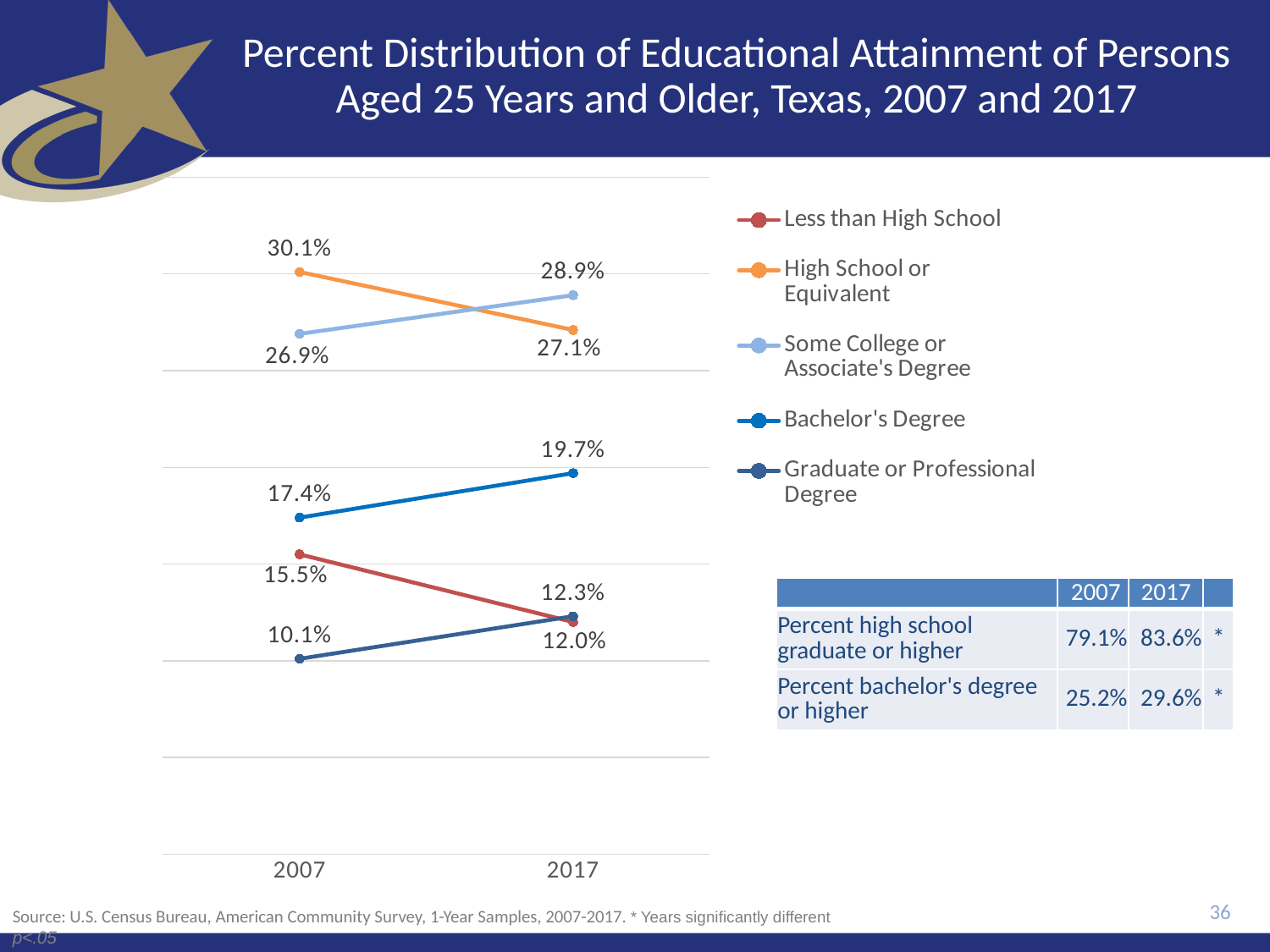
What is the value for High School or Equivalent in 2007? 30.1% Does the value for High School or Equivalent rise or fall from 2007 to 2017? fall Which series has the highest value in 2007? High School or Equivalent What is the value for Less than High School in 2007? 15.5% Which is larger in 2017: Some College or Associate's Degree or High School or Equivalent? Some College or Associate's Degree How many series does the chart legend list? 5 What type of chart is shown on the slide? line chart By how much did the value for Less than High School change from 2007 to 2017? 3.5 percentage points lower What is the value for Graduate or Professional Degree in 2007? 10.1% Which series has the lowest value in 2017? Less than High School What is the value for Bachelor's Degree in 2017? 19.7% What is the value for Some College or Associate's Degree in 2017? 28.9%